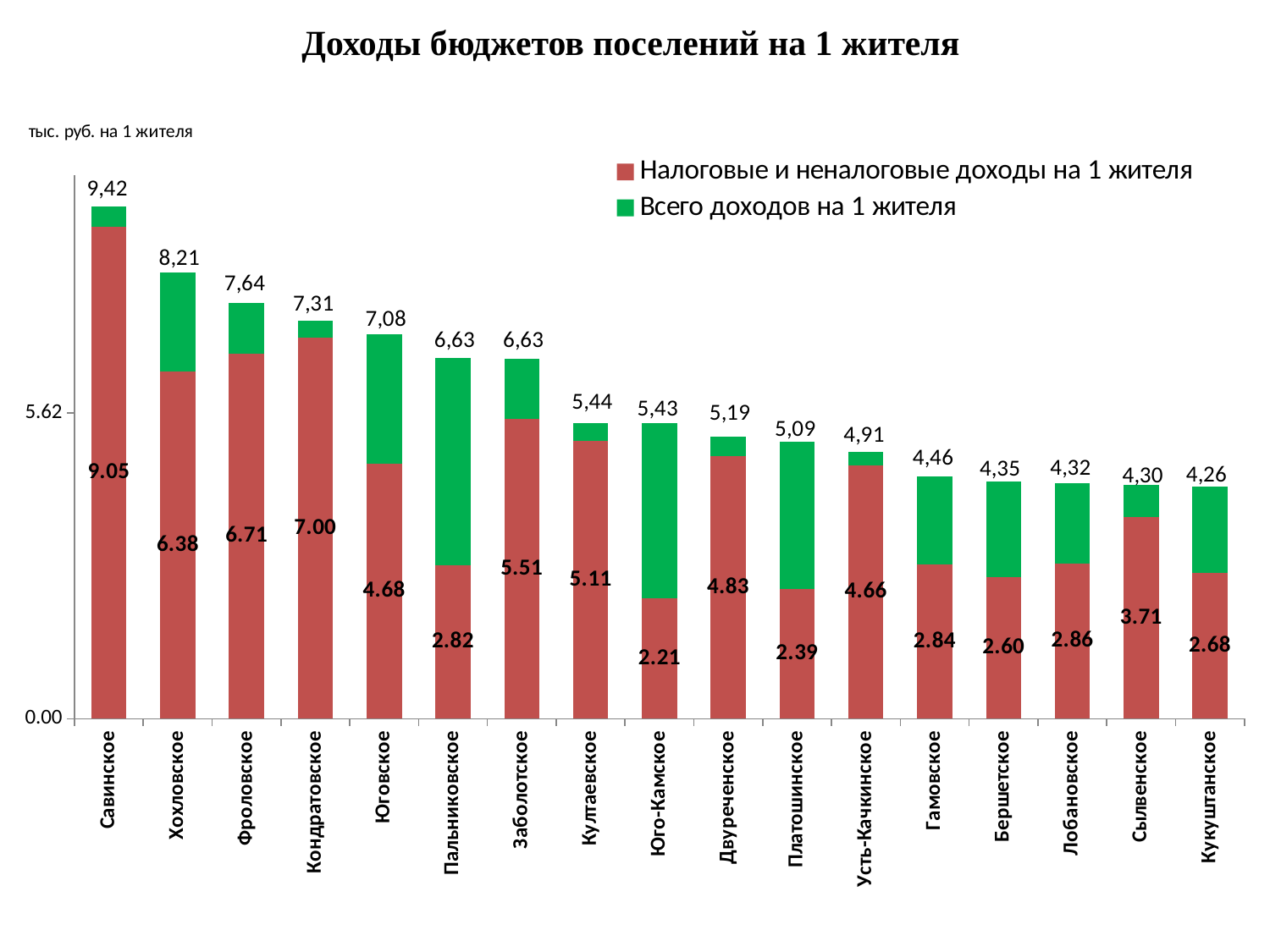
How many series does the legend list? 2 Which settlement has the highest total revenue per resident? Савинское What kind of chart is shown on the slide? bar chart Is the total revenue per resident for Кондратовское greater or less than 5.62? greater Which has the larger 'Налоговые и неналоговые доходы на 1 жителя' value: Юговское or Двуреченское? Двуреченское What is the total revenue per resident (label above the bar) for Хохловское? 8,21 What is the value of 'Налоговые и неналоговые доходы на 1 жителя' for Юго-Камское? 2.21 How many settlements (categories) are shown on the x axis? 17 What is the value of 'Налоговые и неналоговые доходы на 1 жителя' for Савинское? 9.05 What is the difference between the total revenue per resident for Савинское (9,42) and Хохловское (8,21)? 1,21 Which settlement has the lowest total revenue per resident? Кукуштанское What colour represents 'Всего доходов на 1 жителя' in the legend? green